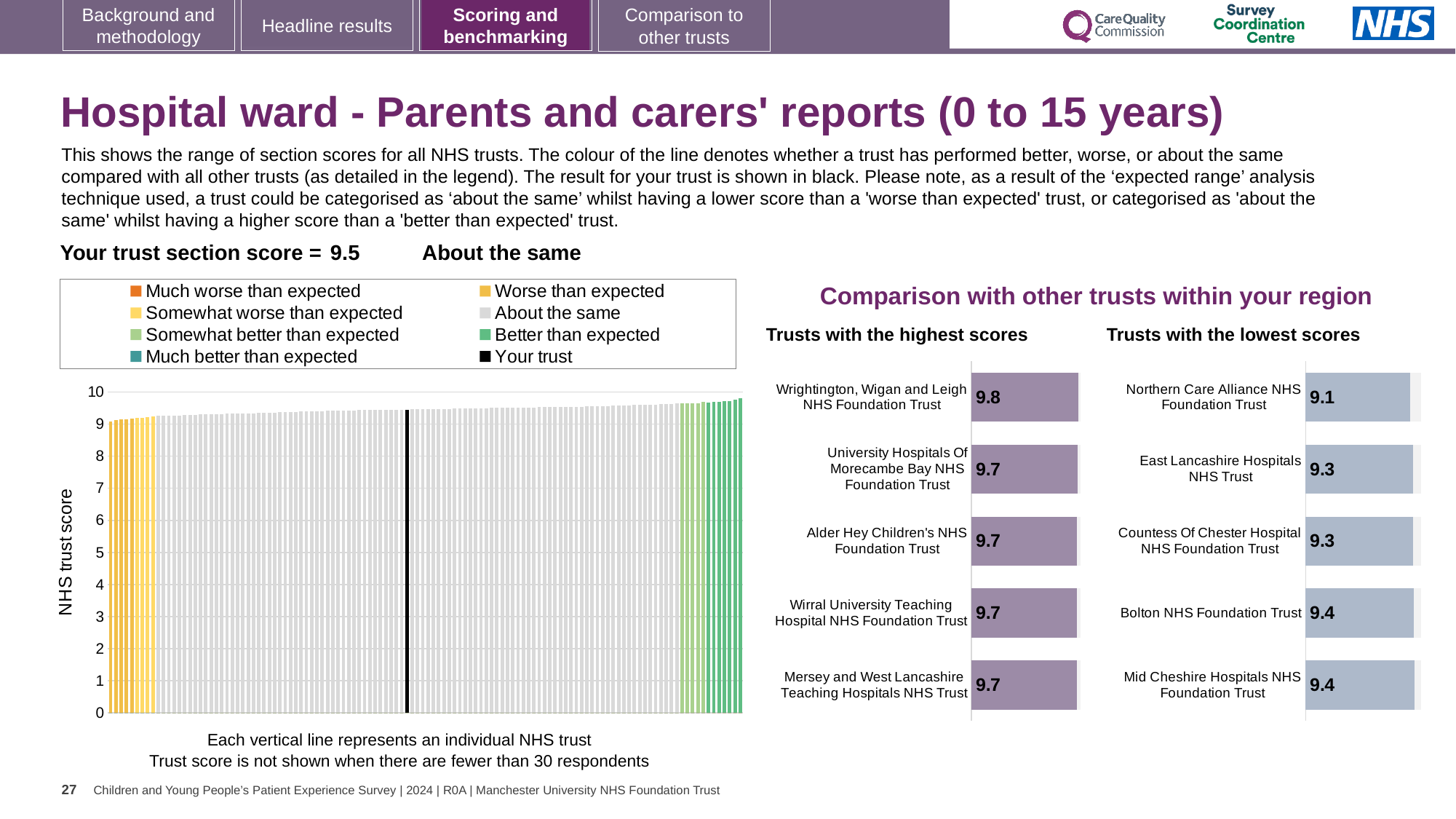
In the 'Trusts with the lowest scores' chart, which trust has the lowest score? Northern Care Alliance NHS Foundation Trust In the 'Trusts with the lowest scores' chart, which has the larger score: Bolton NHS Foundation Trust or East Lancashire Hospitals NHS Trust? Bolton NHS Foundation Trust How many entries does the legend of the 'NHS trust score' chart on the left list? 8 What kind of chart is the 'NHS trust score' chart on the left of the slide? Bar chart How many trusts are shown in the 'Trusts with the highest scores' chart? 5 What is the difference between the score for Wrightington, Wigan and Leigh NHS Foundation Trust in the highest scores chart and the score for Northern Care Alliance NHS Foundation Trust in the lowest scores chart? 0.7 In the 'Trusts with the highest scores' chart, which trust has the highest score? Wrightington, Wigan and Leigh NHS Foundation Trust How many trusts are shown in the 'Trusts with the lowest scores' chart? 5 In the 'Trusts with the lowest scores' chart, what is the score for Northern Care Alliance NHS Foundation Trust? 9.1 In the 'NHS trust score' chart on the left, what is the section score for your trust? 9.5 In the 'Trusts with the lowest scores' chart, is the value for Mid Cheshire Hospitals NHS Foundation Trust greater or less than 9? greater In the 'Trusts with the highest scores' chart, what is the score for Wrightington, Wigan and Leigh NHS Foundation Trust? 9.8